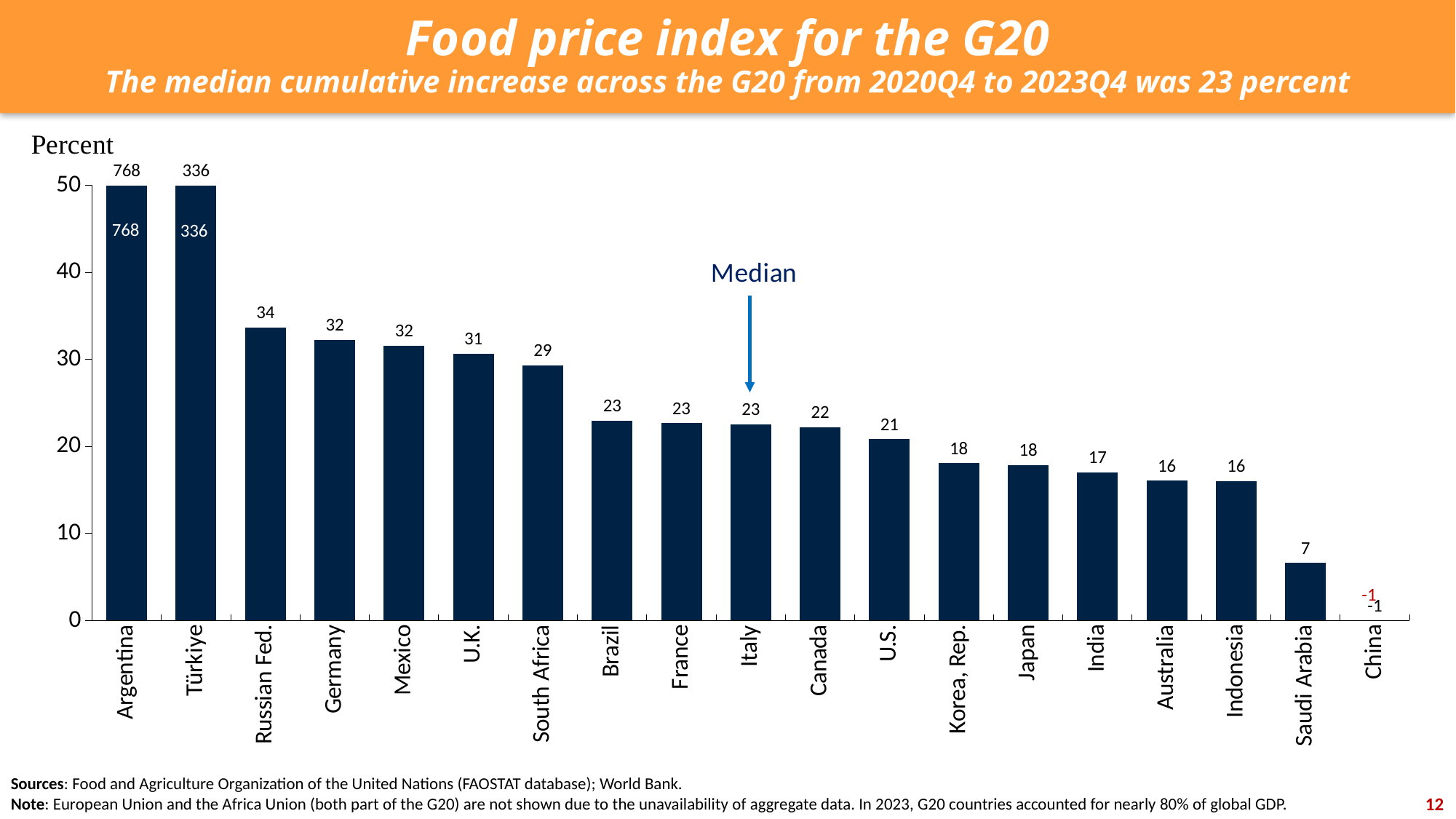
Which country is marked as the median on the chart? Italy What is the value for Argentina? 768 What is the difference between the values for Russian Fed. and Saudi Arabia? 27 Do the values rise or fall from left to right along the x axis? Fall How many countries are shown on the chart? 19 What is the value for China? -1 Which country has the highest value? Argentina What is the value for South Africa? 29 What is the value for Türkiye? 336 Which is larger, the value for U.K. or the value for Canada? U.K. Which country has the lowest value? China What kind of chart is shown on the slide? Bar chart